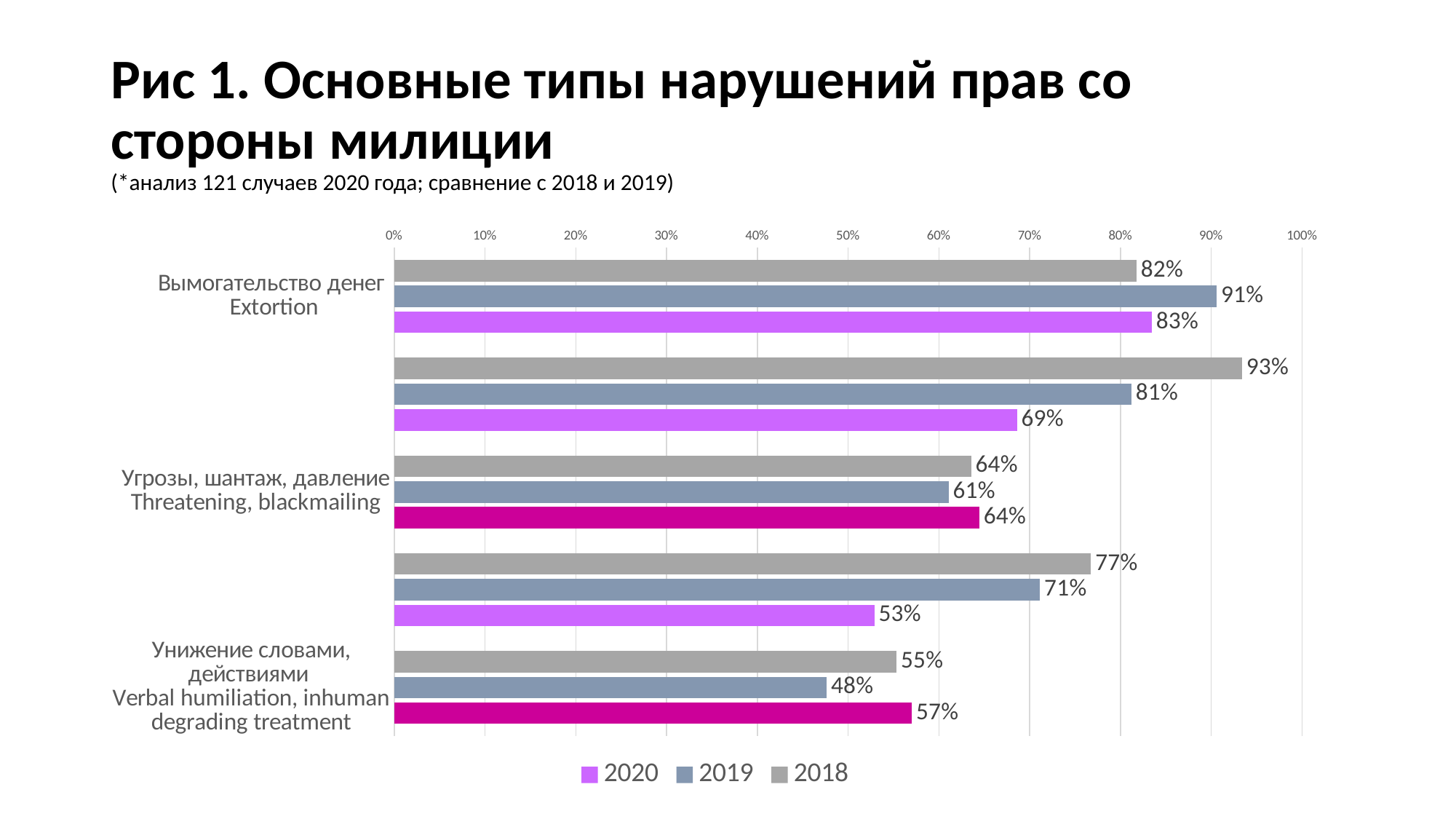
How many series does the legend list? 3 What is the difference between the 2019 and 2018 values for Extortion? 9% What is the value for Threatening, blackmailing in 2019? 61% Which is larger for Verbal humiliation, inhuman degrading treatment: the 2020 value or the 2019 value? 2020 What is the value for Verbal humiliation, inhuman degrading treatment in 2020? 57% Which colour represents the 2018 series in the legend? Grey Which year has the lowest value for Verbal humiliation, inhuman degrading treatment? 2019 Which year has the highest value for Extortion? 2019 What is the value for Extortion in 2020? 83% What is the value for Extortion in 2019? 91% What is the value for Verbal humiliation, inhuman degrading treatment in 2018? 55% What kind of chart is shown on the slide? Bar chart